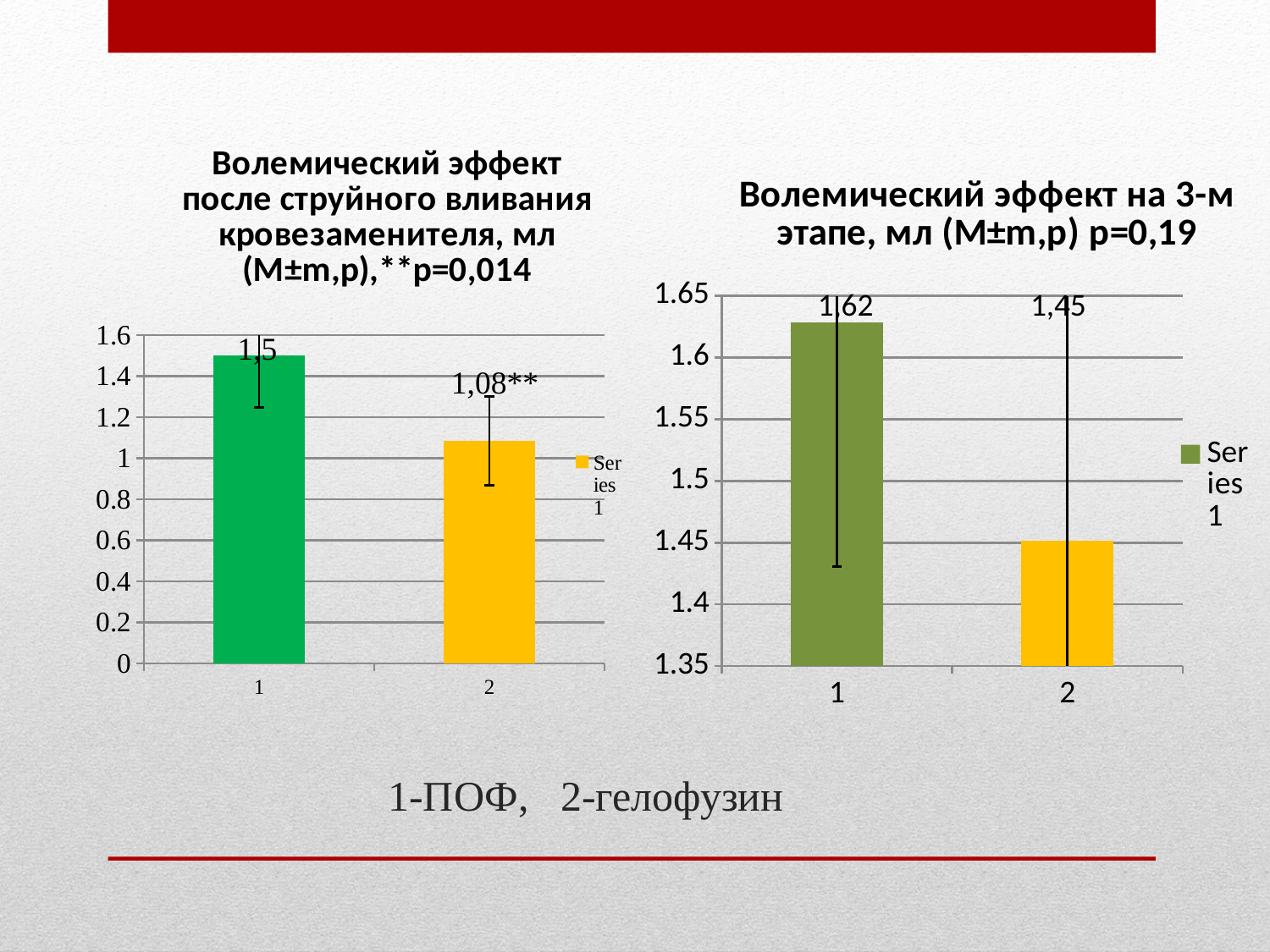
In the left chart, which category has the higher value? 1 In the left chart, what is the difference between the values for category 1 and category 2? 0,42 In the left chart (Волемический эффект после струйного вливания кровезаменителя), what is the data label shown for category 2? 1,08** In the right chart (Волемический эффект на 3-м этапе), what is the value for category 2? 1,45 In the right chart, is the value for category 2 greater or less than 1.5? less How many categories are shown in the left chart? 2 How many series does the legend of the right chart list? 1 In the right chart, what is the difference between the values for category 1 and category 2? 0,17 In the right chart, which category has the lower value? 2 What type of chart is the right chart (Волемический эффект на 3-м этапе)? bar chart In the right chart (Волемический эффект на 3-м этапе), what is the value for category 1? 1,62 In the left chart (Волемический эффект после струйного вливания кровезаменителя), what is the value for category 1? 1,5